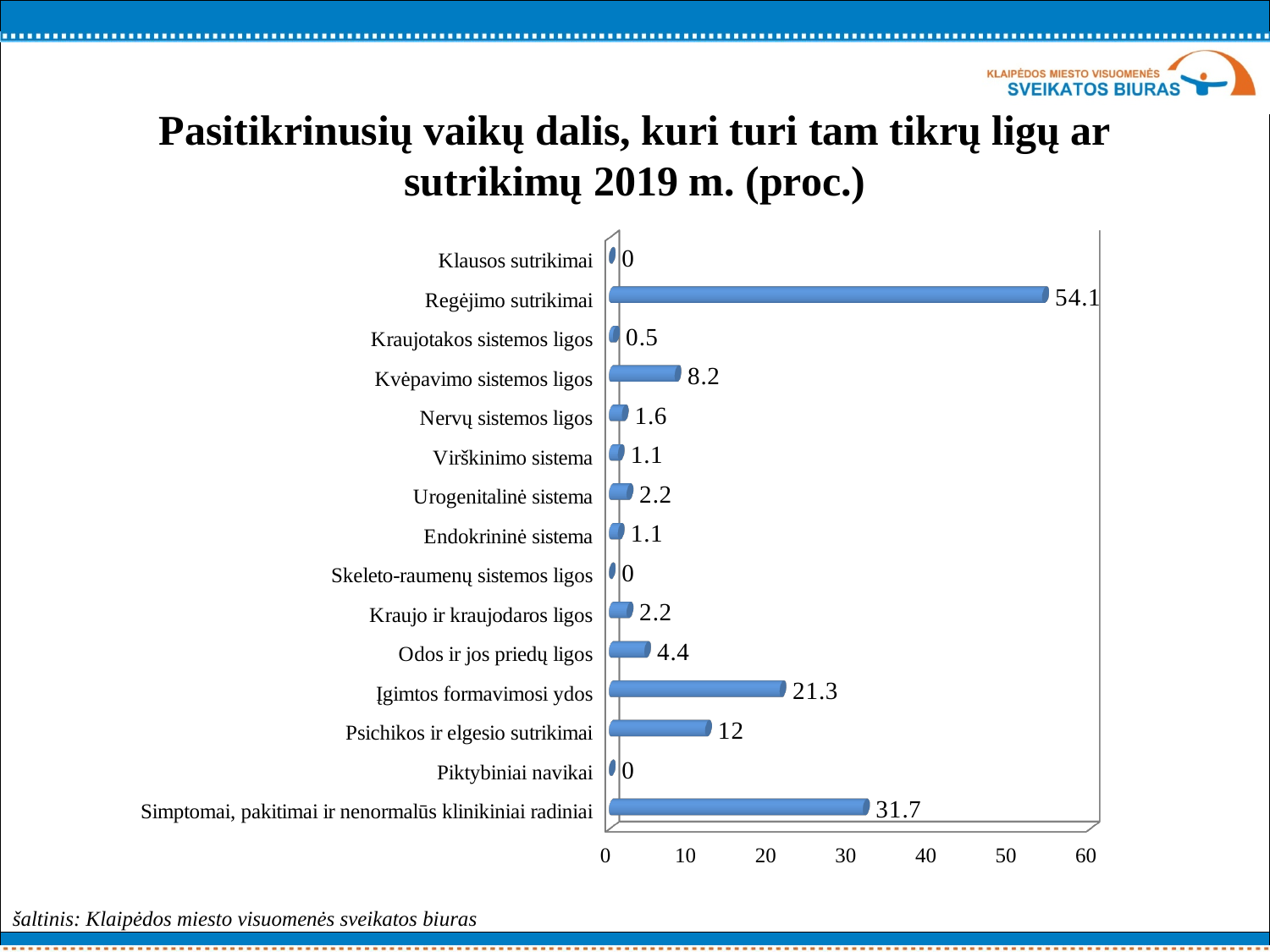
What is the value for Įgimtos formavimosi ydos? 21.3 How many categories are shown in the chart? 15 What is the difference between the values for Regėjimo sutrikimai and Simptomai, pakitimai ir nenormalūs klinikiniai radiniai? 22.4 What is the value for Psichikos ir elgesio sutrikimai? 12 Is the value for Regėjimo sutrikimai greater or less than 50? greater What is the value for Simptomai, pakitimai ir nenormalūs klinikiniai radiniai? 31.7 Which category has the highest value? Regėjimo sutrikimai What kind of chart is shown on the slide? bar chart Which is larger, the value for Odos ir jos priedų ligos or the value for Kvėpavimo sistemos ligos? Kvėpavimo sistemos ligos What is the value for Kvėpavimo sistemos ligos? 8.2 What is the value for Regėjimo sutrikimai? 54.1 What is the difference between the values for Įgimtos formavimosi ydos and Psichikos ir elgesio sutrikimai? 9.3